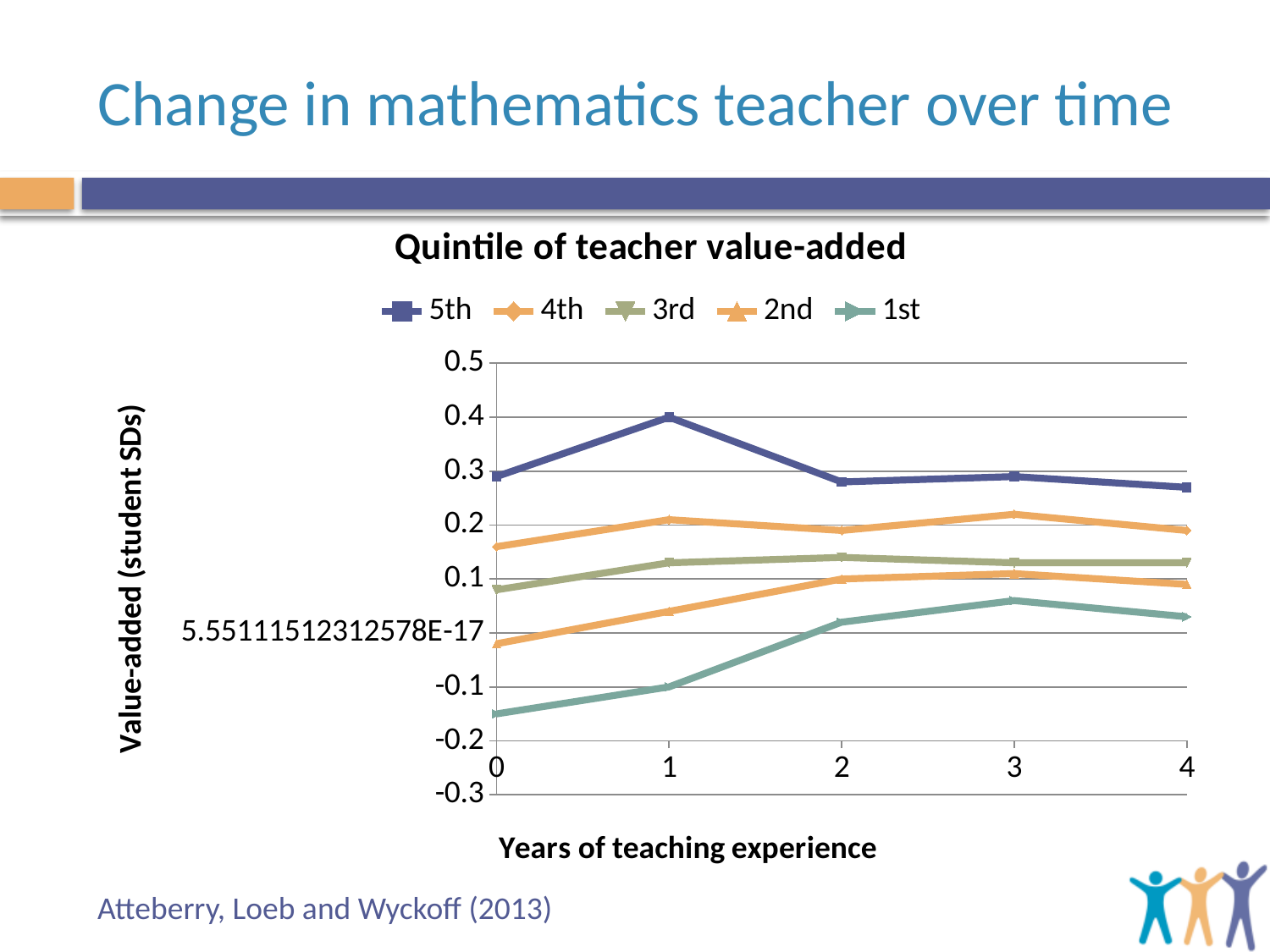
Is the value for the 1st quintile at 0 years of experience greater or less than -0.1? less Which quintile has the highest value-added at 4 years of experience? 5th At which year of teaching experience does the 5th quintile line reach its peak? 1 Which quintile has the lowest value-added at 0 years of experience? 1st Is the value for the 5th quintile at 1 year of experience greater or less than 0.3? greater Does the 1st quintile line rise or fall from 0 to 3 years of experience? rise At 0 years of experience, which is larger: the value for the 5th quintile or the 1st quintile? 5th Is the value for the 1st quintile at 2 years of experience greater or less than 0.1? less What is the title of the x axis? Years of teaching experience What kind of chart is shown on the slide? line chart How many series does the legend list? 5 How many years of teaching experience are plotted along the x axis? 5